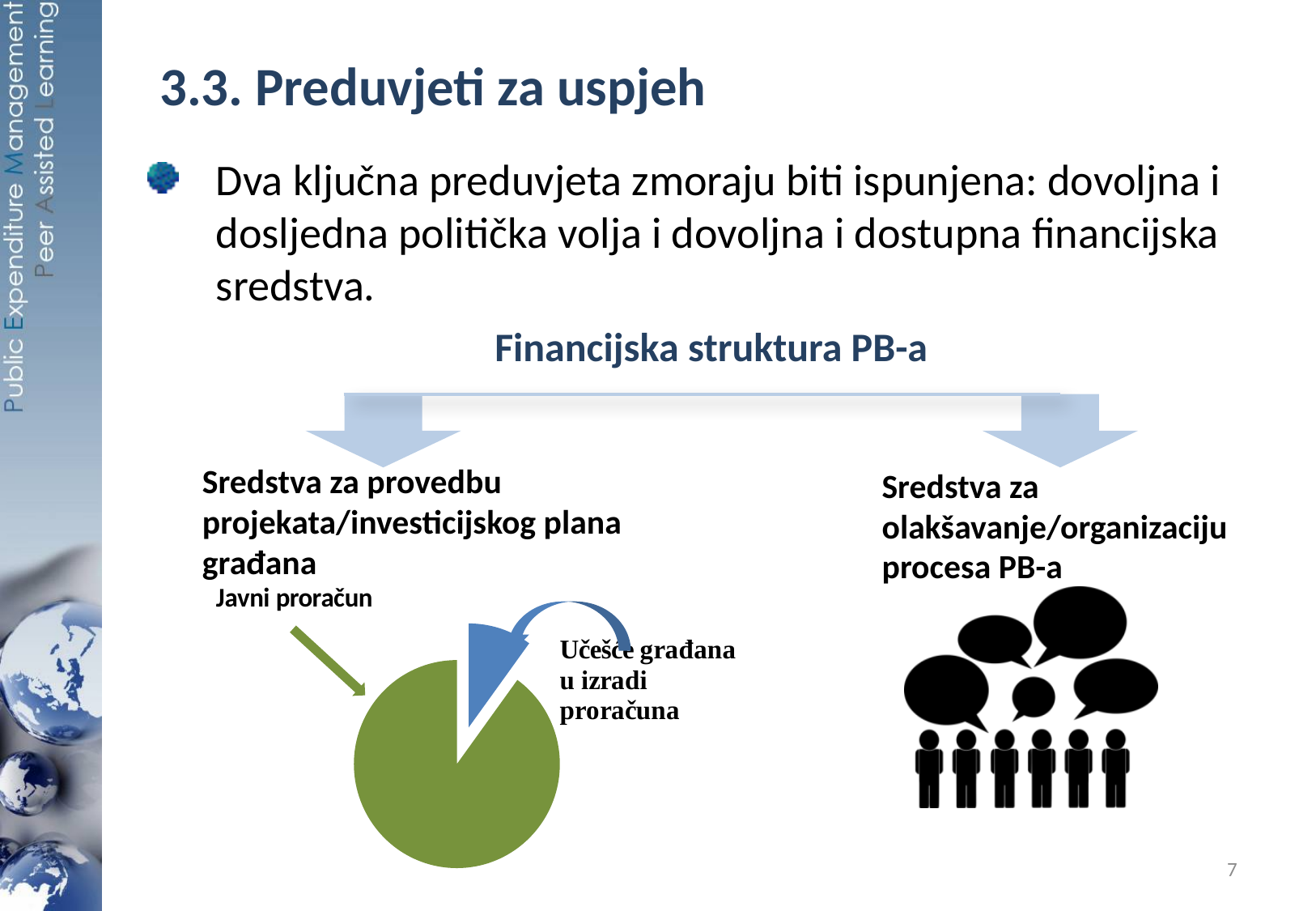
What colour is the "Javni proračun" slice of the pie chart? green How many slices does the pie chart have? 2 Which slice of the pie chart is larger, "Javni proračun" or "Učešće građana u izradi proračuna"? Javni proračun What colour is the "Učešće građana u izradi proračuna" slice of the pie chart? blue What kind of chart is shown on the slide under "Financijska struktura PB-a"? pie chart Which slice of the pie chart is the largest? Javni proračun Which slice of the pie chart is the smallest? Učešće građana u izradi proračuna